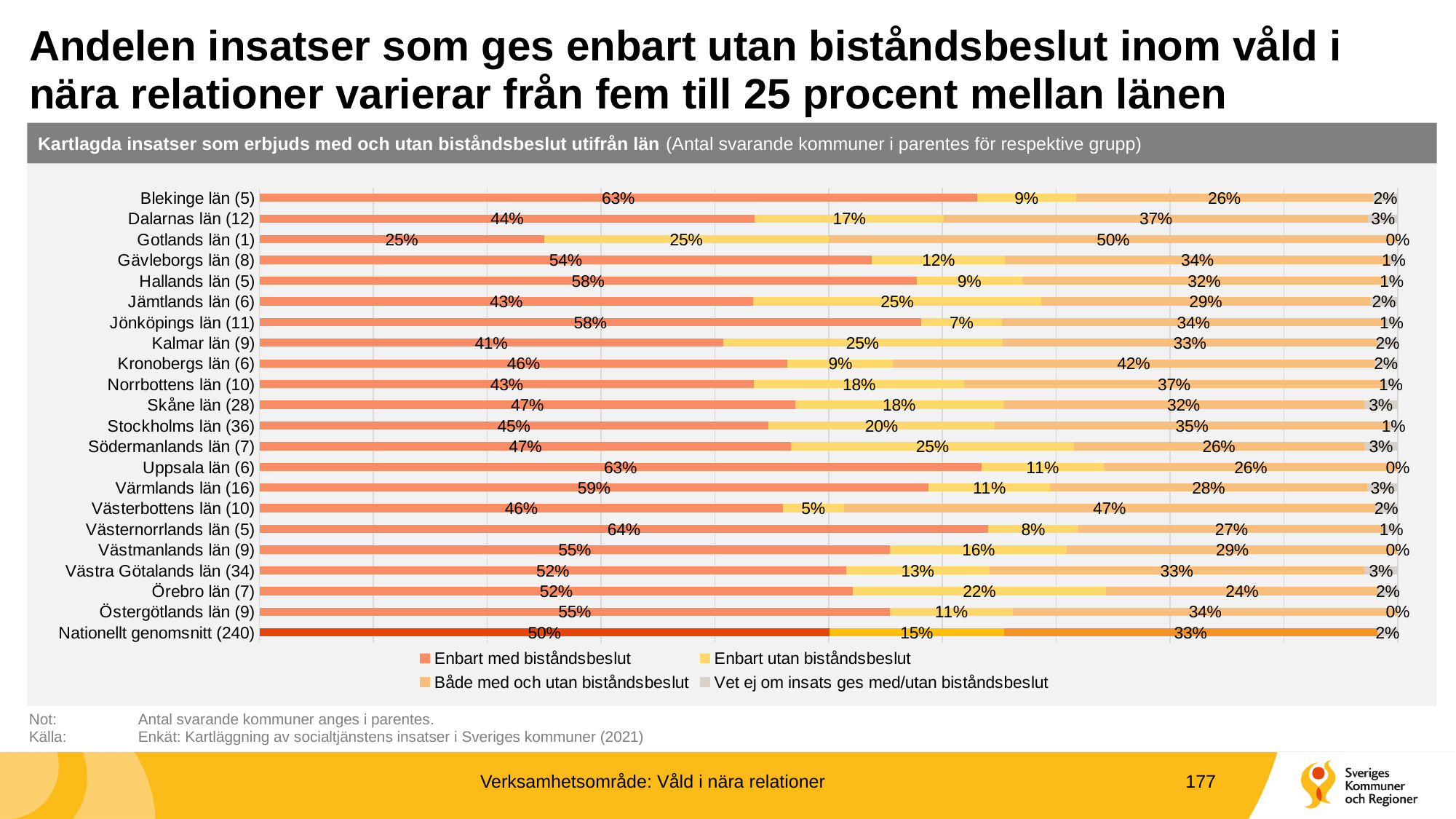
How many series does the legend list? 4 Which has a larger value for 'Enbart utan biståndsbeslut': Skåne län (28) or Örebro län (7)? Örebro län (7) How many categories (rows) are plotted in the chart, including the national average? 22 Which category has the lowest value for 'Enbart utan biståndsbeslut'? Västerbottens län (10) What is the difference in 'Enbart med biståndsbeslut' between Blekinge län (5) and Dalarnas län (12)? 19 percentage points What kind of chart is shown on the slide? Stacked bar chart What is the total of the stacked bar for Blekinge län (5)? 100% Which category has the highest value for 'Enbart med biståndsbeslut'? Västernorrlands län (5) What is the value of 'Enbart utan biståndsbeslut' for Nationellt genomsnitt (240)? 15% What is the value of 'Enbart med biståndsbeslut' for Blekinge län (5)? 63% What is the value of 'Både med och utan biståndsbeslut' for Gotlands län (1)? 50% What is the title of the chart? Kartlagda insatser som erbjuds med och utan biståndsbeslut utifrån län